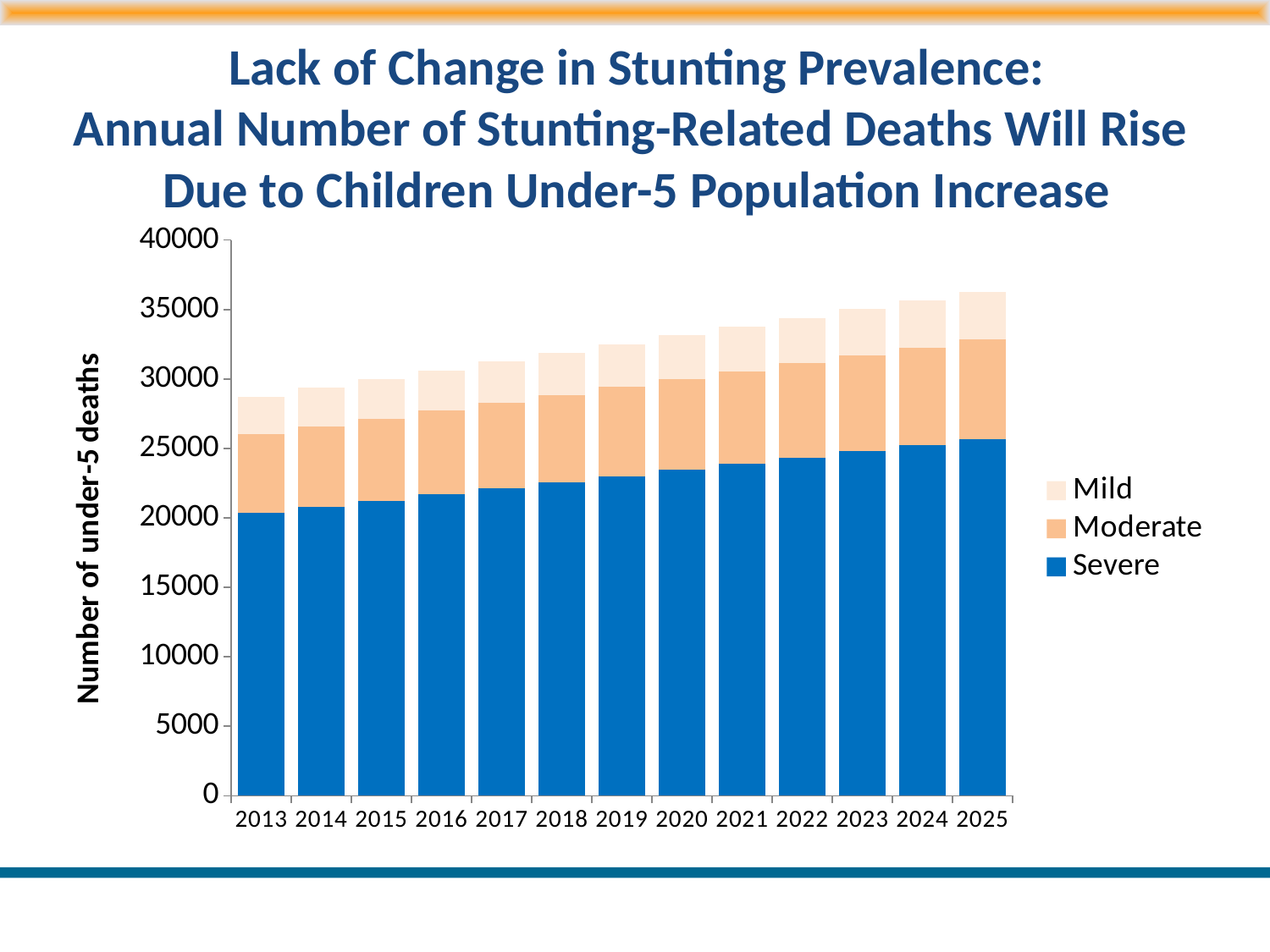
What kind of chart is shown on the slide? Stacked bar chart Which year has the highest total number of under-5 deaths? 2025 Is the total number of under-5 deaths in 2013 greater or less than 30000? less Do the total stunting-related deaths rise or fall from 2013 to 2025? Rise How many series does the chart's legend list? 3 How many years are shown on the x axis of the chart? 13 Is the Severe value for 2025 greater or less than 25000? greater What is the label of the vertical axis? Number of under-5 deaths Which series is shown in dark blue in the chart? Severe Which is larger, the Severe value for 2013 or the Severe value for 2025? 2025 Which year has the lowest total number of under-5 deaths? 2013 Is the total number of under-5 deaths in 2025 greater or less than 35000? greater